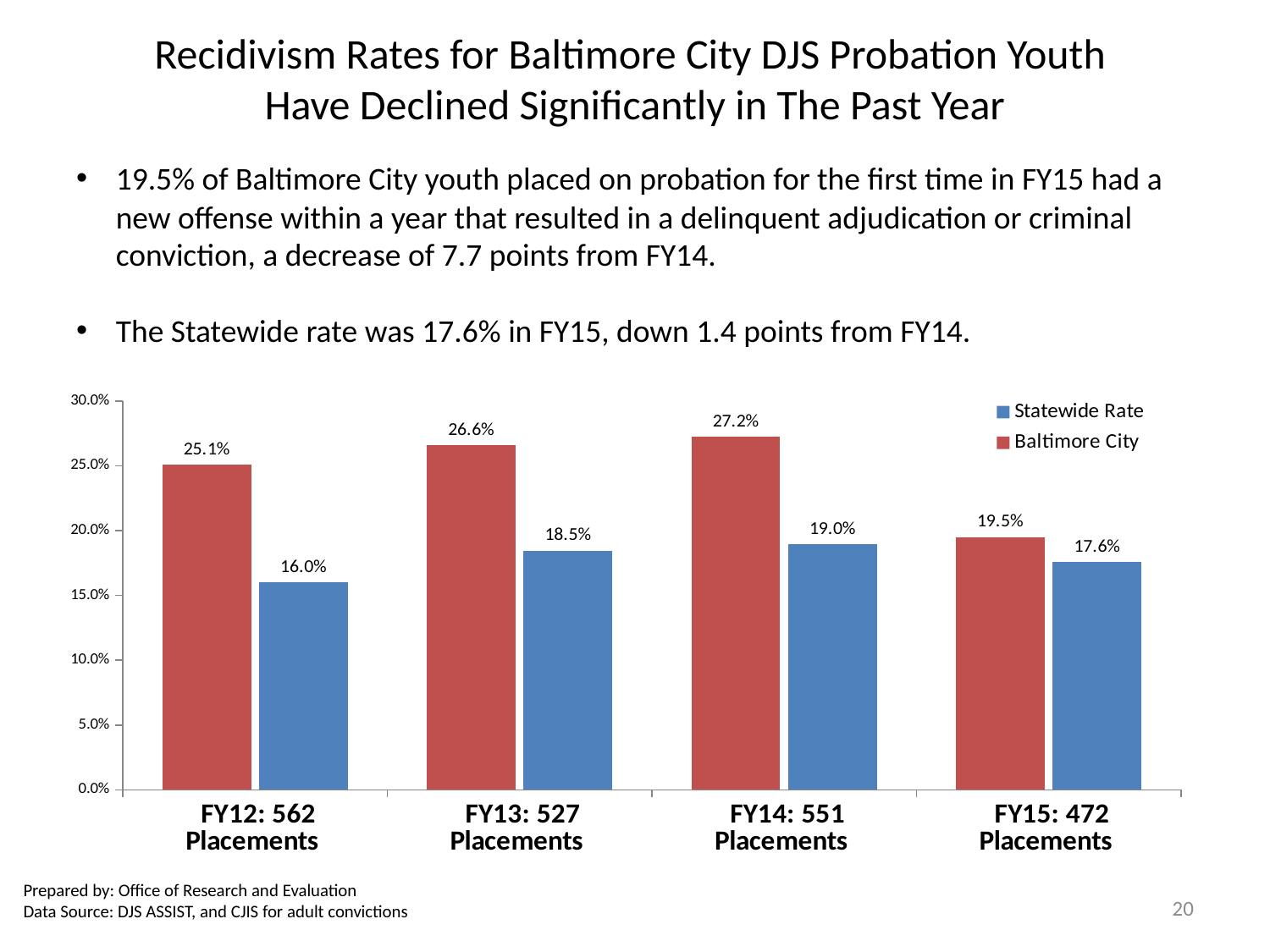
By how many points did the Baltimore City rate fall from FY14 to FY15? 7.7 points In which fiscal year category is the Baltimore City rate highest? FY14: 551 Placements In which fiscal year category is the Statewide Rate lowest? FY12: 562 Placements What is the Statewide Rate for FY12: 562 Placements? 16.0% How many fiscal year categories are shown on the x axis? 4 Which is larger for FY13: 527 Placements, the Baltimore City rate or the Statewide Rate? Baltimore City How many series does the legend list? 2 What kind of chart is shown on the slide? Bar chart What is the difference between the Baltimore City rate and the Statewide Rate for FY14: 551 Placements? 8.2 points Is the Baltimore City rate for FY12: 562 Placements greater or less than 20.0%? greater What is the Baltimore City recidivism rate for FY15: 472 Placements? 19.5% What is the Baltimore City rate for FY13: 527 Placements? 26.6%